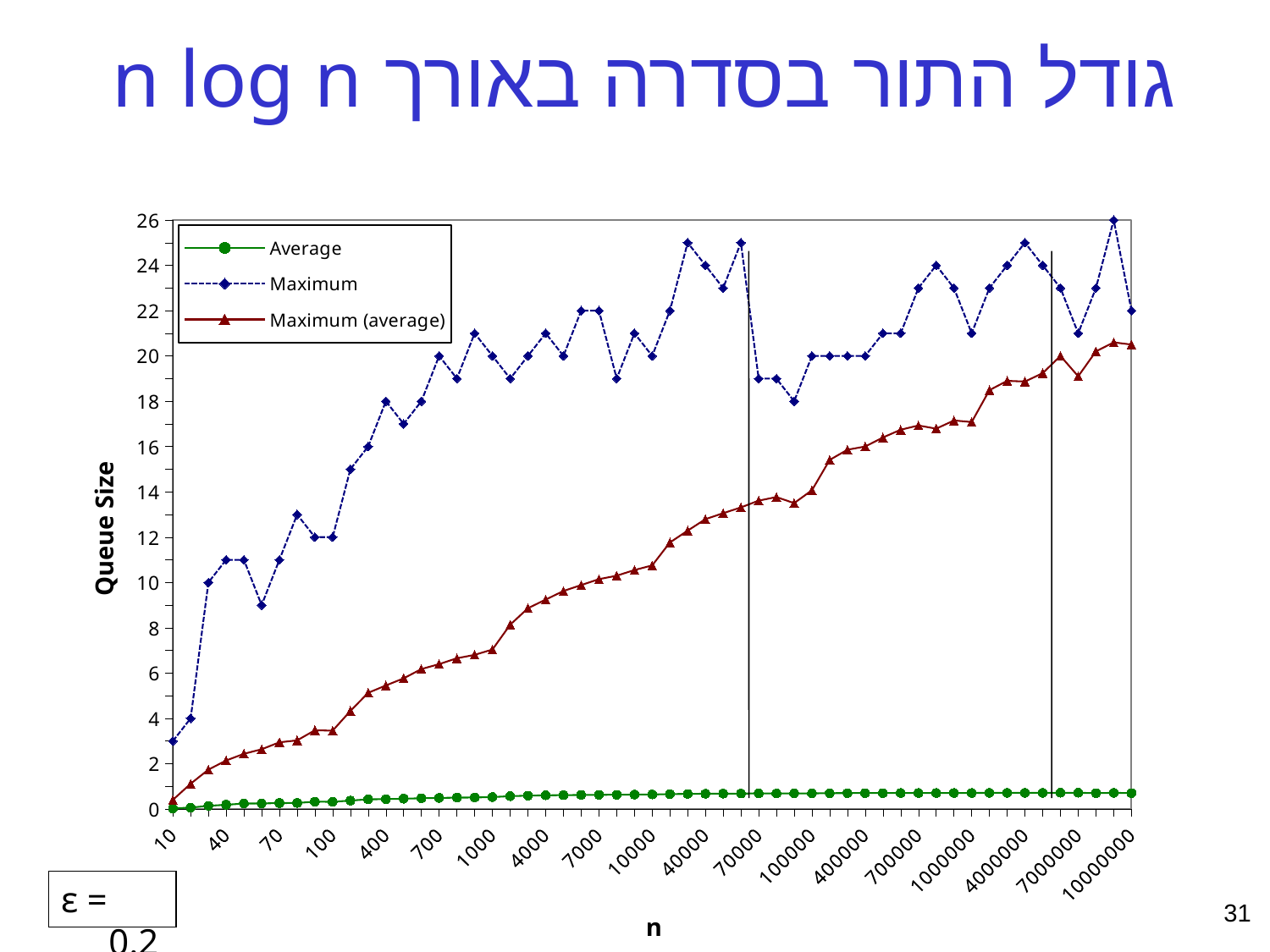
At n = 1000, which is larger: the Maximum value or the Average value? Maximum Is the Maximum (average) value at n = 10000000 greater or less than 18? greater Is the Average value at n = 10000000 greater or less than 2? less Does the Maximum (average) series generally rise or fall as n increases? rise What kind of chart is shown on the slide? line chart What is the title of the vertical axis? Queue Size Which series is drawn with a dashed line? Maximum What is the highest value reached by the Maximum series? 26 What is the Maximum value at n = 700? 20 How many labels are shown on the x axis? 19 How many series does the legend list? 3 What is the Maximum value at n = 10000000? 22